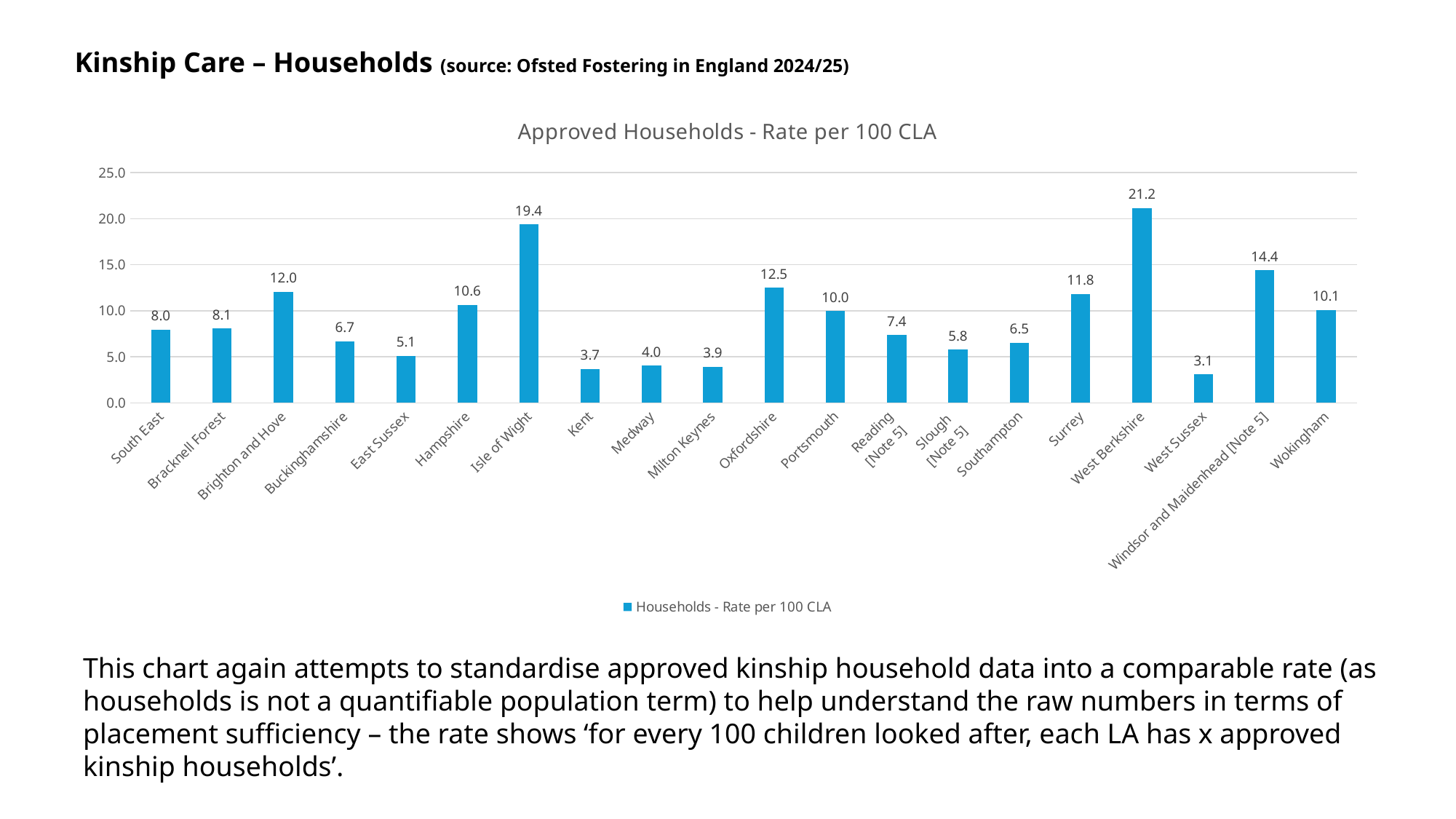
What is the approved households rate per 100 CLA for Kent? 3.7 Which local authority has the lowest approved households rate per 100 CLA? West Sussex What is the difference between the rates for West Berkshire and Isle of Wight? 1.8 Is the value for Hampshire greater or less than 10.0? greater Which local authority has the highest approved households rate per 100 CLA? West Berkshire Which has a higher approved households rate per 100 CLA, Oxfordshire or Surrey? Oxfordshire What is the approved households rate per 100 CLA for Isle of Wight? 19.4 What kind of chart is shown on the slide? Bar chart What is the approved households rate per 100 CLA for Windsor and Maidenhead [Note 5]? 14.4 How many series does the legend list? 1 How many local authorities (categories) are shown on the chart? 20 What is the title of the chart? Approved Households - Rate per 100 CLA